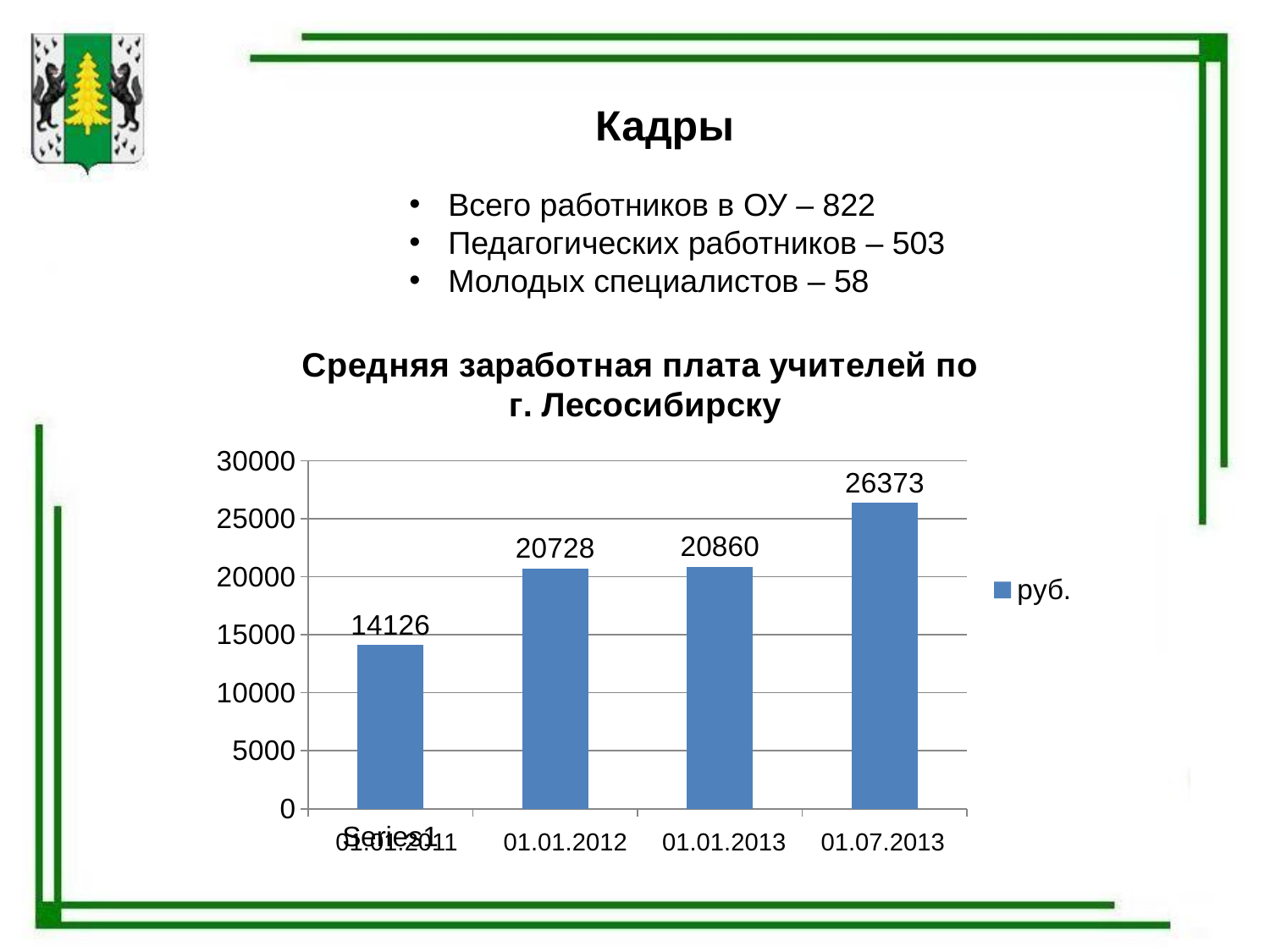
What is the difference between the values for 01.01.2012 and 01.01.2011? 6602 How many dates (bars) are shown in the chart? 4 What is the value shown for 01.07.2013? 26373 Which date has the lowest average teacher salary? 01.01.2011 What type of chart is shown on the slide? bar chart What is the difference between the values for 01.07.2013 and 01.01.2013? 5513 What is the value shown for 01.01.2011? 14126 Which date has the highest average teacher salary? 01.07.2013 What is the value shown for 01.01.2013? 20860 What is the legend entry of the chart? руб. What is the average teacher salary shown for 01.01.2012? 20728 Which is larger, the value for 01.01.2012 or the value for 01.01.2011? 01.01.2012